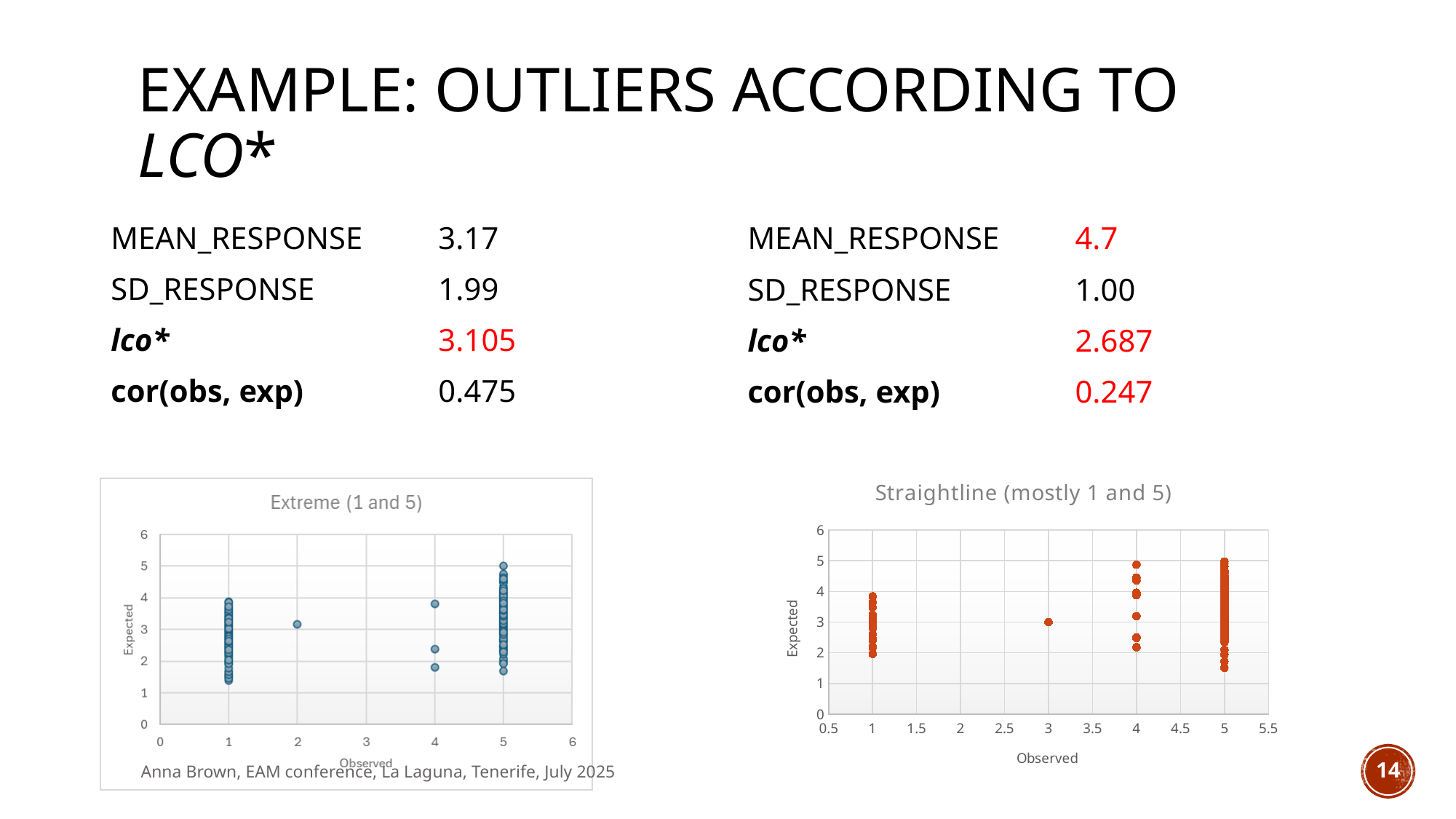
In the 'Straightline (mostly 1 and 5)' chart, is the Expected value of the point at Observed = 3 greater or less than 2? greater In the 'Extreme (1 and 5)' chart, is the highest Expected value at Observed = 5 greater or less than 4? greater In the 'Straightline (mostly 1 and 5)' chart, how many points are plotted at Observed = 3? 1 What kind of chart is the 'Extreme (1 and 5)' chart? scatter chart What is the title of the chart on the left of the slide? Extreme (1 and 5) In the 'Straightline (mostly 1 and 5)' chart, how many distinct Observed values have points plotted? 4 What kind of chart is the 'Straightline (mostly 1 and 5)' chart? scatter chart In the 'Extreme (1 and 5)' chart, how many distinct Observed values have points plotted? 4 In the 'Straightline (mostly 1 and 5)' chart, what is the label of the y axis? Expected In the 'Extreme (1 and 5)' chart, is the Expected value of the point at Observed = 2 greater or less than 2? greater